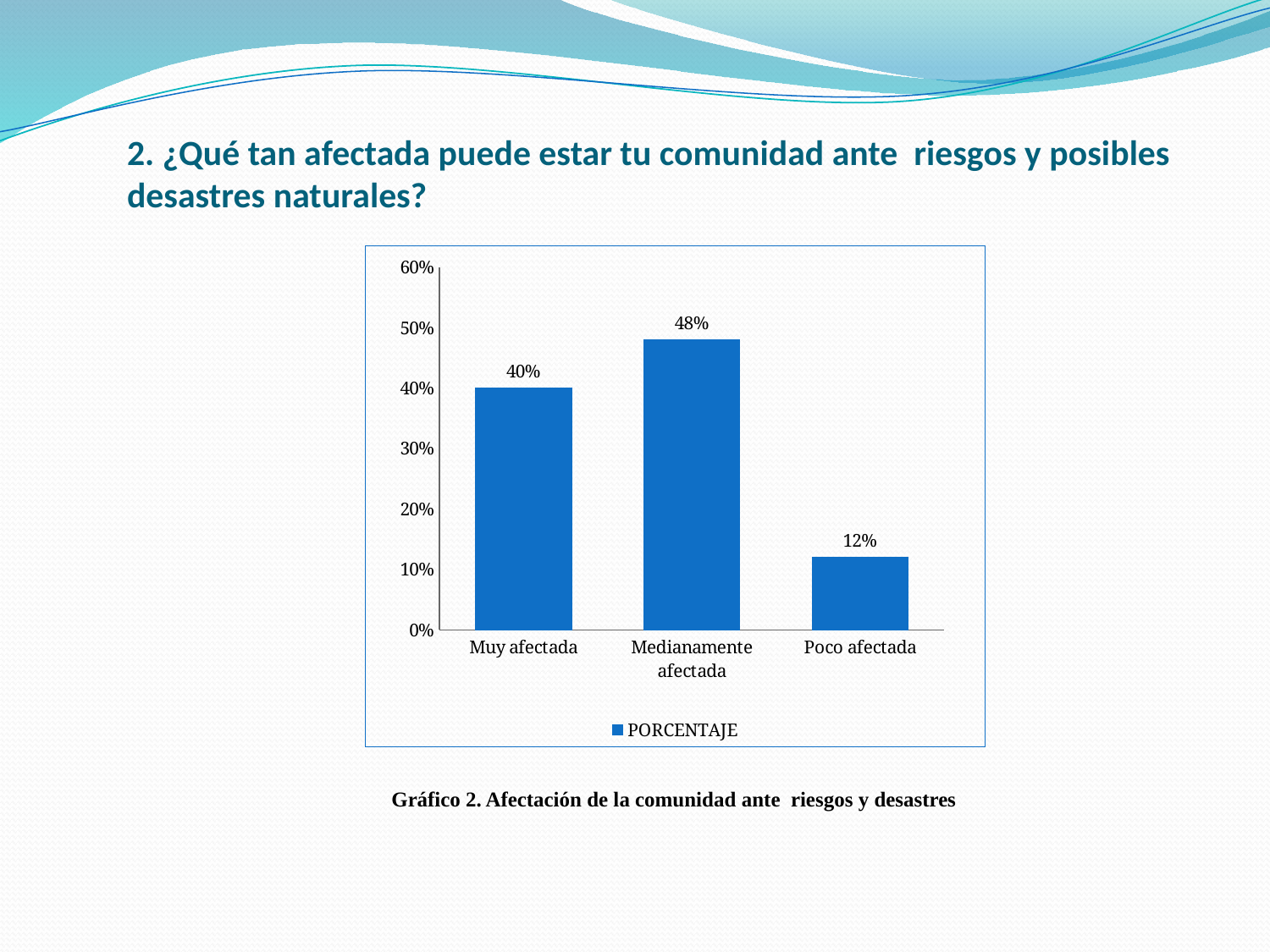
Which is larger, the value for Muy afectada or the value for Poco afectada? Muy afectada What is the difference between the values for Medianamente afectada and Muy afectada? 8% How many categories are shown on the x axis? 3 What is the value for Poco afectada? 12% What is the value for Medianamente afectada? 48% Which category has the highest value? Medianamente afectada Which category has the lowest value? Poco afectada What is the value for Muy afectada? 40% What kind of chart is shown on the slide? bar chart What is the difference between the values for Muy afectada and Poco afectada? 28% How many series does the legend list? 1 Is the value for Medianamente afectada greater or less than 50%? less